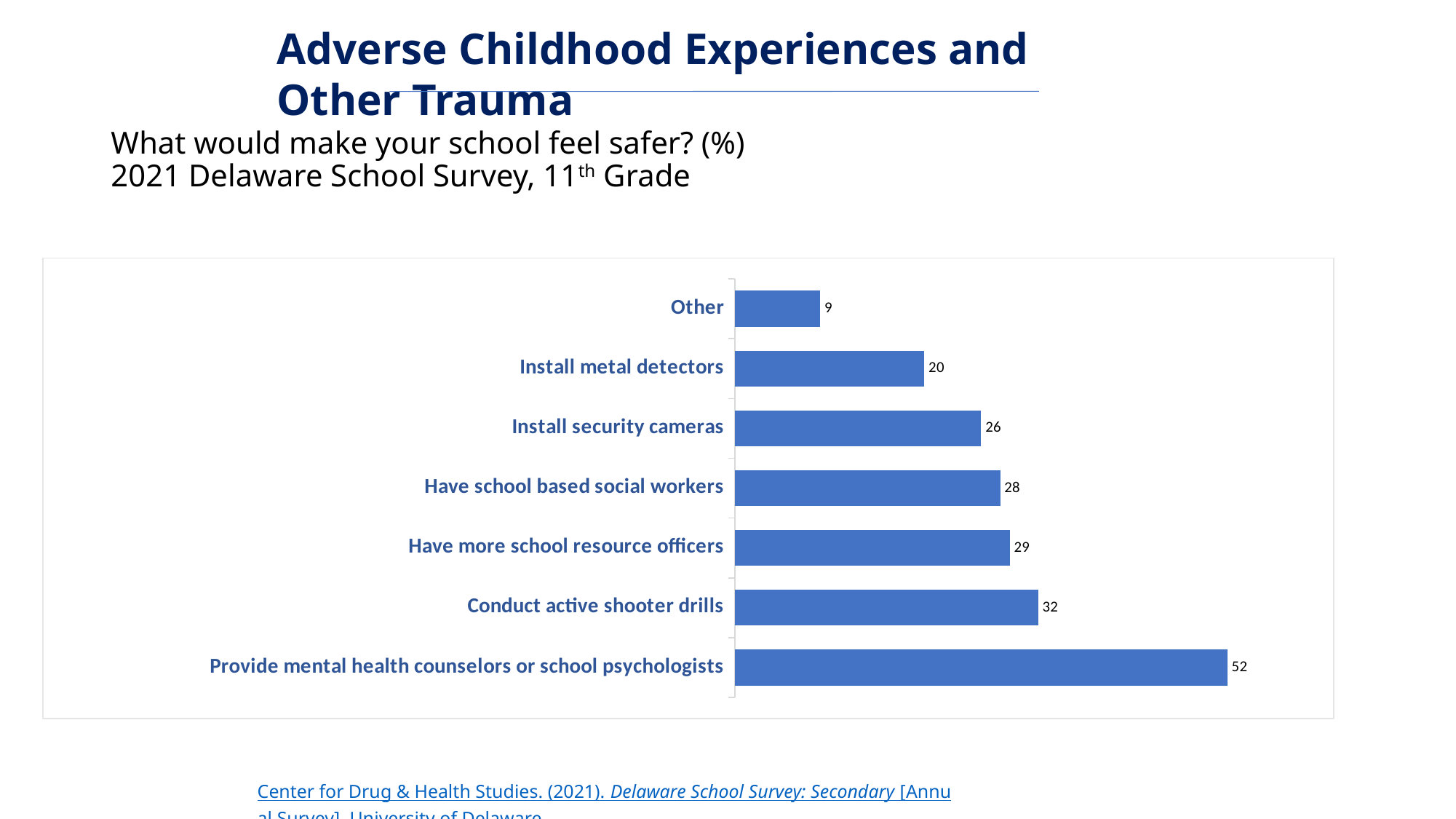
Which category has the highest value? Provide mental health counselors or school psychologists Which category has the lowest value? Other What is the difference between the values for 'Install security cameras' and 'Install metal detectors'? 6 How many categories are shown in the chart? 7 What value is shown for 'Install metal detectors'? 20 What percentage of 11th graders said providing mental health counselors or school psychologists would make their school feel safer? 52 What is the difference between the values for 'Provide mental health counselors or school psychologists' and 'Conduct active shooter drills'? 20 What value is shown for 'Have school based social workers'? 28 What value is shown for 'Conduct active shooter drills'? 32 Which is larger: the value for 'Install security cameras' or the value for 'Install metal detectors'? Install security cameras What kind of chart is shown on the slide? Bar chart What survey question does the chart present? What would make your school feel safer? (%)